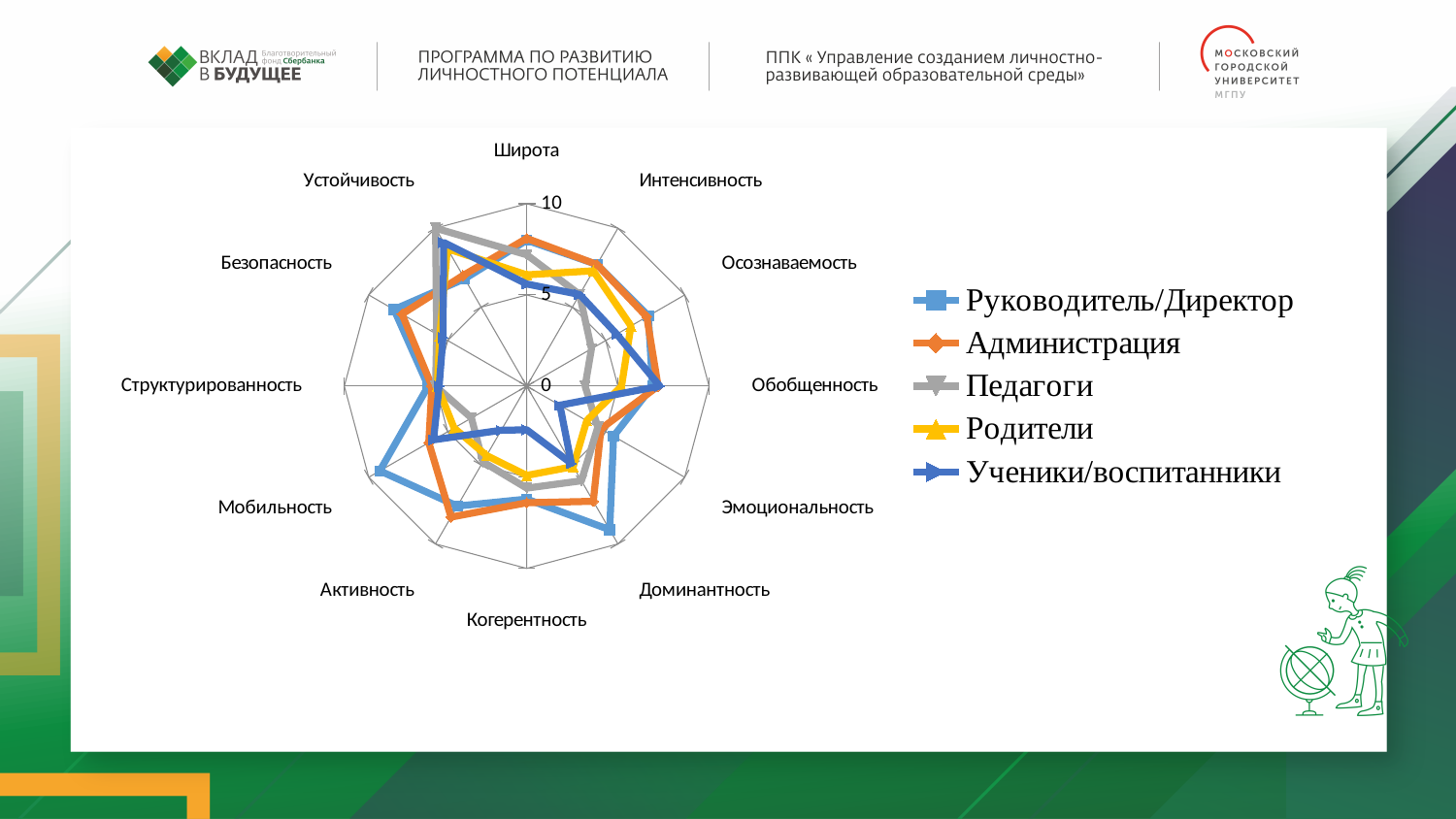
How many series does the legend list? 5 Is the value for Ученики/воспитанники on the Когерентность axis greater or less than 5? less On the Обобщенность axis, which series has the larger value: Администрация or Педагоги? Администрация What is the maximum value shown on the radar chart's axis scale? 10 Which series is drawn in gray in the legend? Педагоги What kind of chart is shown on the slide? radar chart Is the value for Руководитель/Директор on the Доминантность axis greater or less than 5? greater Is the value for Администрация on the Широта axis greater or less than 5? greater How many categories (axes) does the radar chart have? 12 On the Доминантность axis, which series has the larger value: Руководитель/Директор or Педагоги? Руководитель/Директор